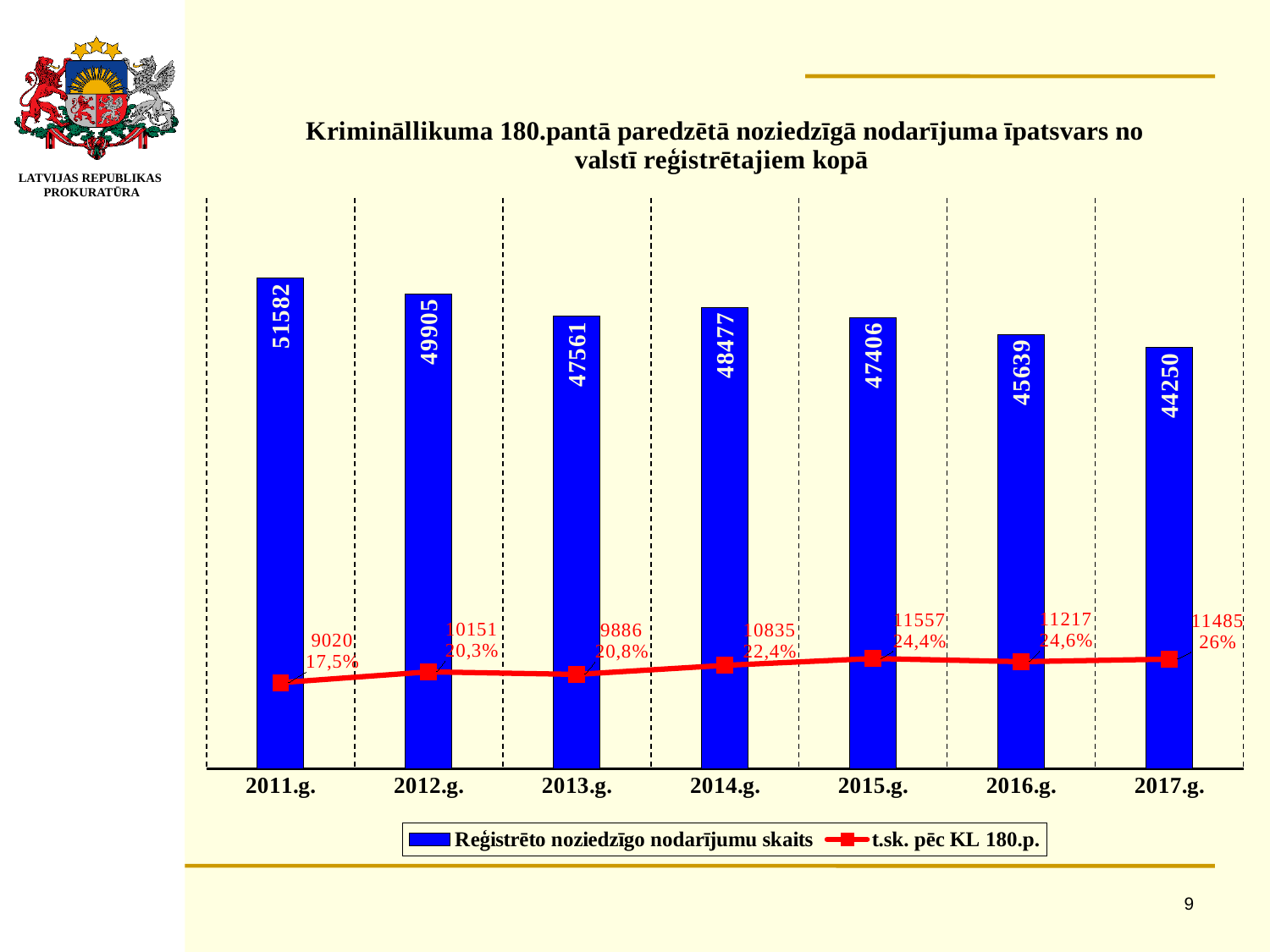
Which year has the highest value of Reģistrēto noziedzīgo nodarījumu skaits? 2011.g. How many years are shown on the x axis? 7 What kind of chart is this? Combined bar and line chart What is the title of the chart? Krimināllikuma 180.pantā paredzētā noziedzīgā nodarījuma īpatsvars no valstī reģistrētajiem kopā What is the difference between Reģistrēto noziedzīgo nodarījumu skaits in 2011.g. and 2017.g.? 7332 Which year has the lowest value of Reģistrēto noziedzīgo nodarījumu skaits? 2017.g. Which year has the lowest value of t.sk. pēc KL 180.p.? 2011.g. What is the value of t.sk. pēc KL 180.p. for 2015.g.? 11557 How many series does the legend list? 2 What percentage is shown for t.sk. pēc KL 180.p. in 2017.g.? 26% What is the value of Reģistrēto noziedzīgo nodarījumu skaits for 2011.g.? 51582 Which is larger: t.sk. pēc KL 180.p. in 2016.g. or in 2017.g.? 2017.g.